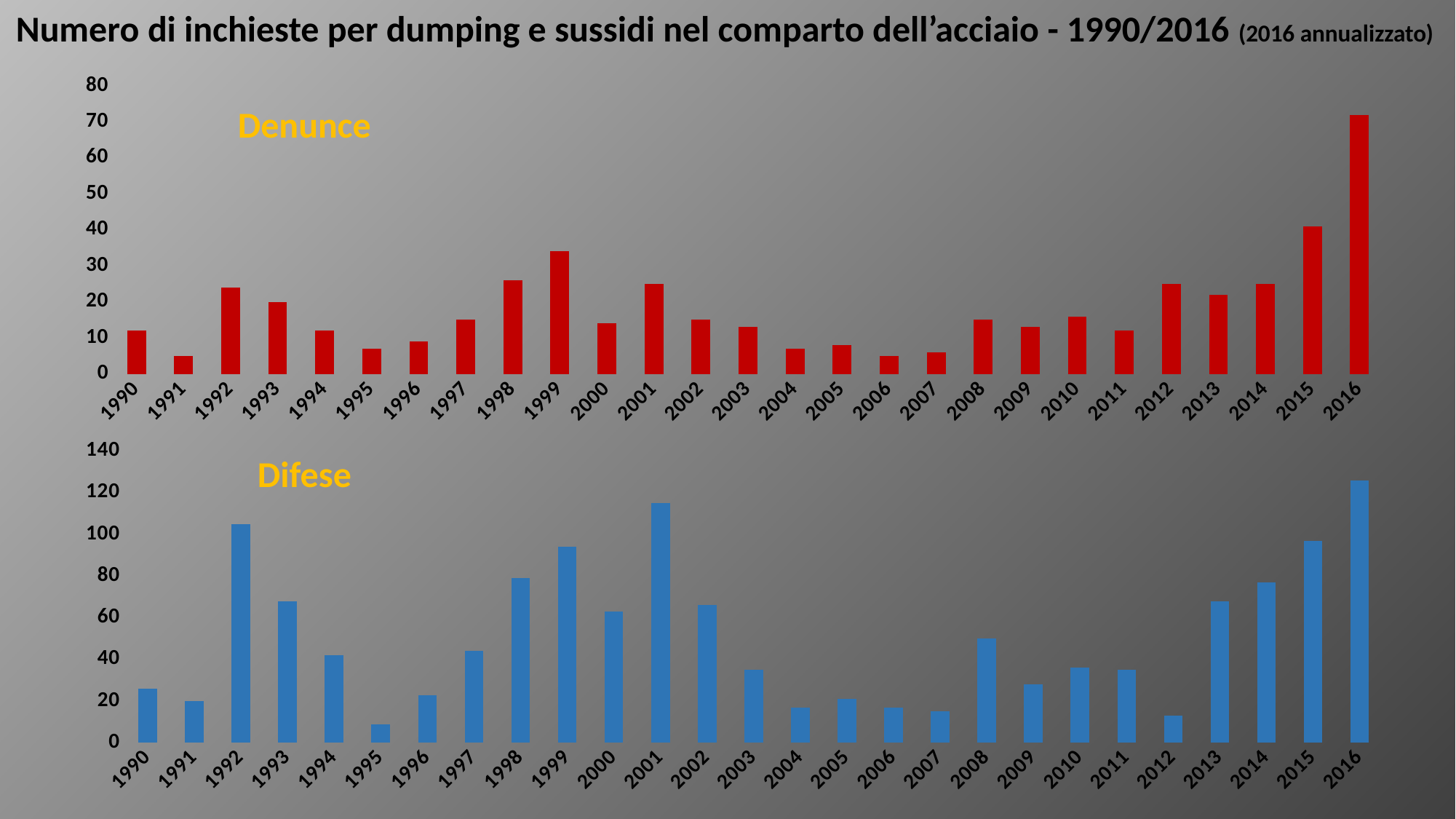
In the Difese chart, which year has the highest value? 2016 In the Denunce chart, which is larger, the value for 2015 or the value for 2016? 2016 What colour are the bars in the Difese chart? blue In the Denunce chart, is the value for 2015 greater or less than 30? greater In the Denunce chart, which year has the highest value? 2016 In the Difese chart, is the value for 2001 greater or less than 100? greater In the Denunce chart, do the values rise or fall from 2011 to 2016? rise In the Difese chart, is the value for 1995 greater or less than 20? less How many years are plotted in the Denunce chart? 27 What kind of chart is the Denunce chart at the top of the slide? bar chart In the Difese chart, which is larger, the value for 1998 or the value for 1999? 1999